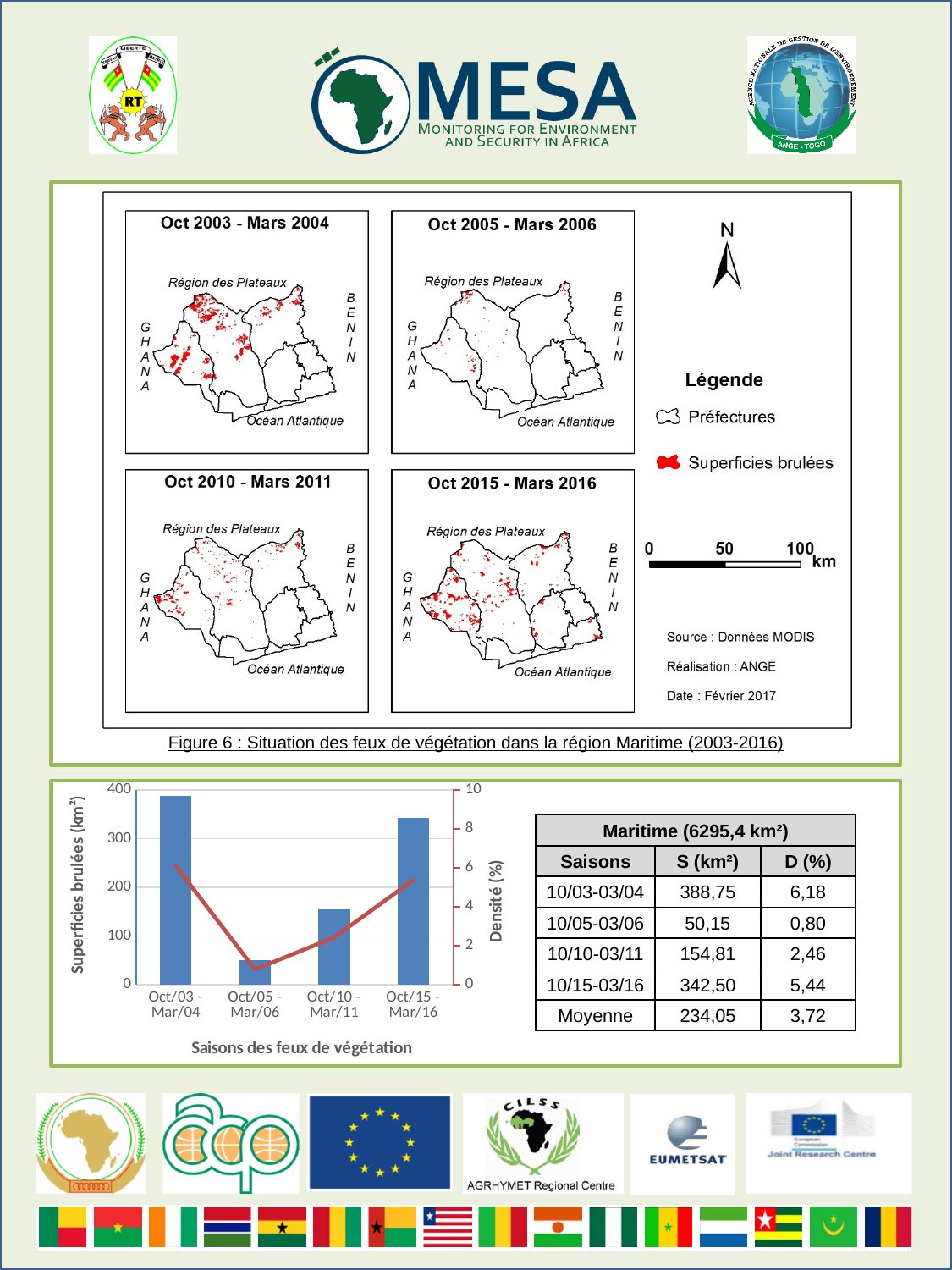
Which season has the highest burned area (Superficies brulées) in the bar chart? Oct/03 - Mar/04 According to the table, what is the burned area S (km²) for the season 10/03-03/04? 388,75 What kind of chart is shown at the bottom left of the slide? A combined bar and line chart According to the table, what is the difference in burned area S (km²) between 10/15-03/16 and 10/10-03/11? 187,69 What is the label of the left vertical axis of the chart? Superficies brulées (km²) Is the burned area bar for Oct/05 - Mar/06 greater or less than 100 km²? less Is the burned area bar for Oct/15 - Mar/16 greater or less than 300 km²? greater Is the burned area bar for Oct/10 - Mar/11 greater or less than 200 km²? less Which season has the lowest burned area (Superficies brulées) in the bar chart? Oct/05 - Mar/06 Which is larger, the burned area for Oct/03 - Mar/04 or for Oct/15 - Mar/16? Oct/03 - Mar/04 According to the table, what is the density D (%) for the season 10/05-03/06? 0,80 How many seasons (categories) are plotted on the x axis of the bar chart? 4